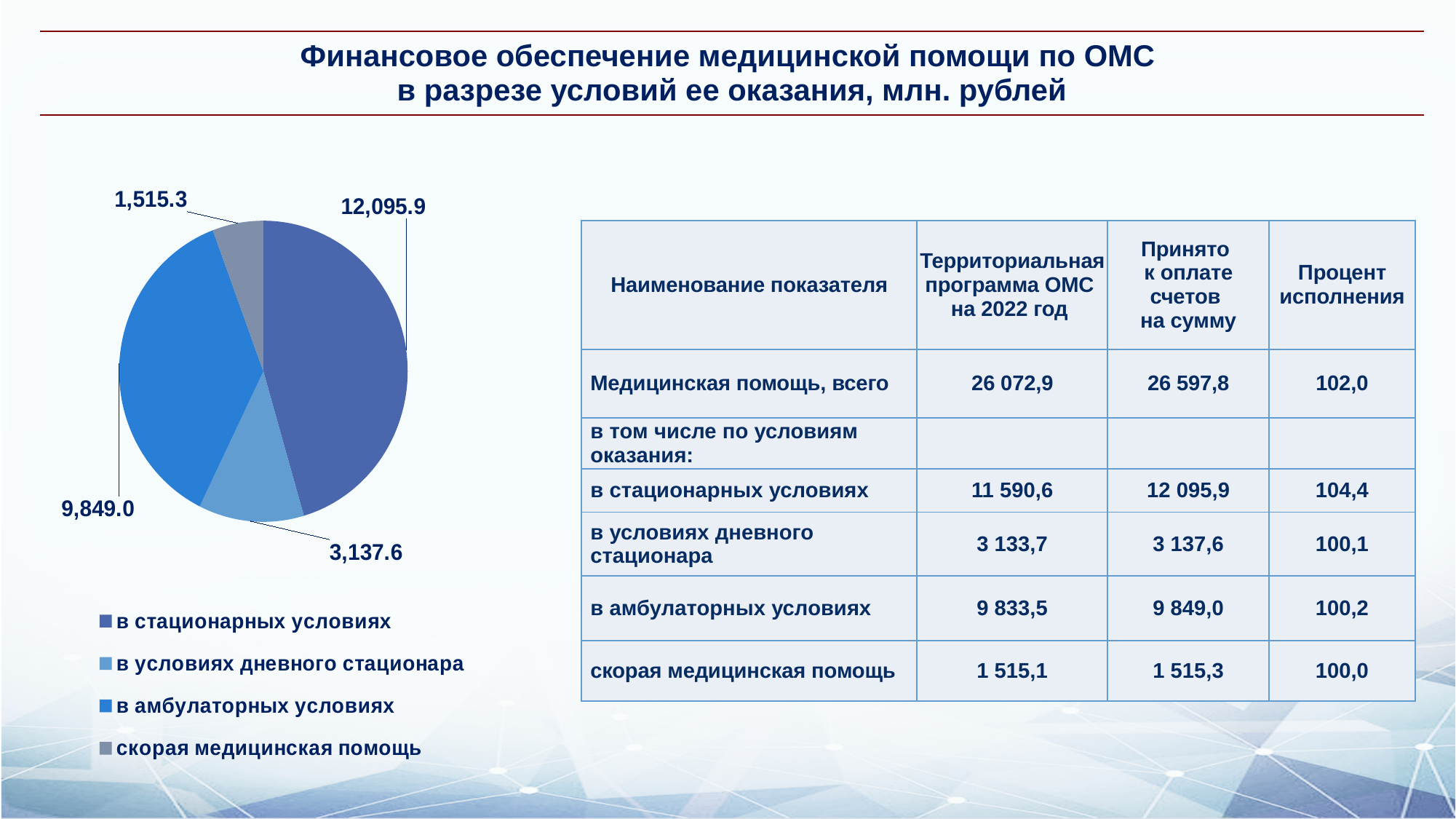
What is the value for в стационарных условиях in the pie chart? 12,095.9 Which category has the smallest slice in the pie chart? скорая медицинская помощь How many entries does the legend of the pie chart list? 4 What type of chart is shown on the slide? pie chart Which is larger in the pie chart: в условиях дневного стационара or в амбулаторных условиях? в амбулаторных условиях Which category has the largest slice in the pie chart? в стационарных условиях How many slices does the pie chart have? 4 What is the difference between the values for в стационарных условиях and в амбулаторных условиях in the pie chart? 2,246.9 What is the value for скорая медицинская помощь in the pie chart? 1,515.3 What share of the pie chart does скорая медицинская помощь represent? 5.7% What is the value for в условиях дневного стационара in the pie chart? 3,137.6 What is the value for в амбулаторных условиях in the pie chart? 9,849.0